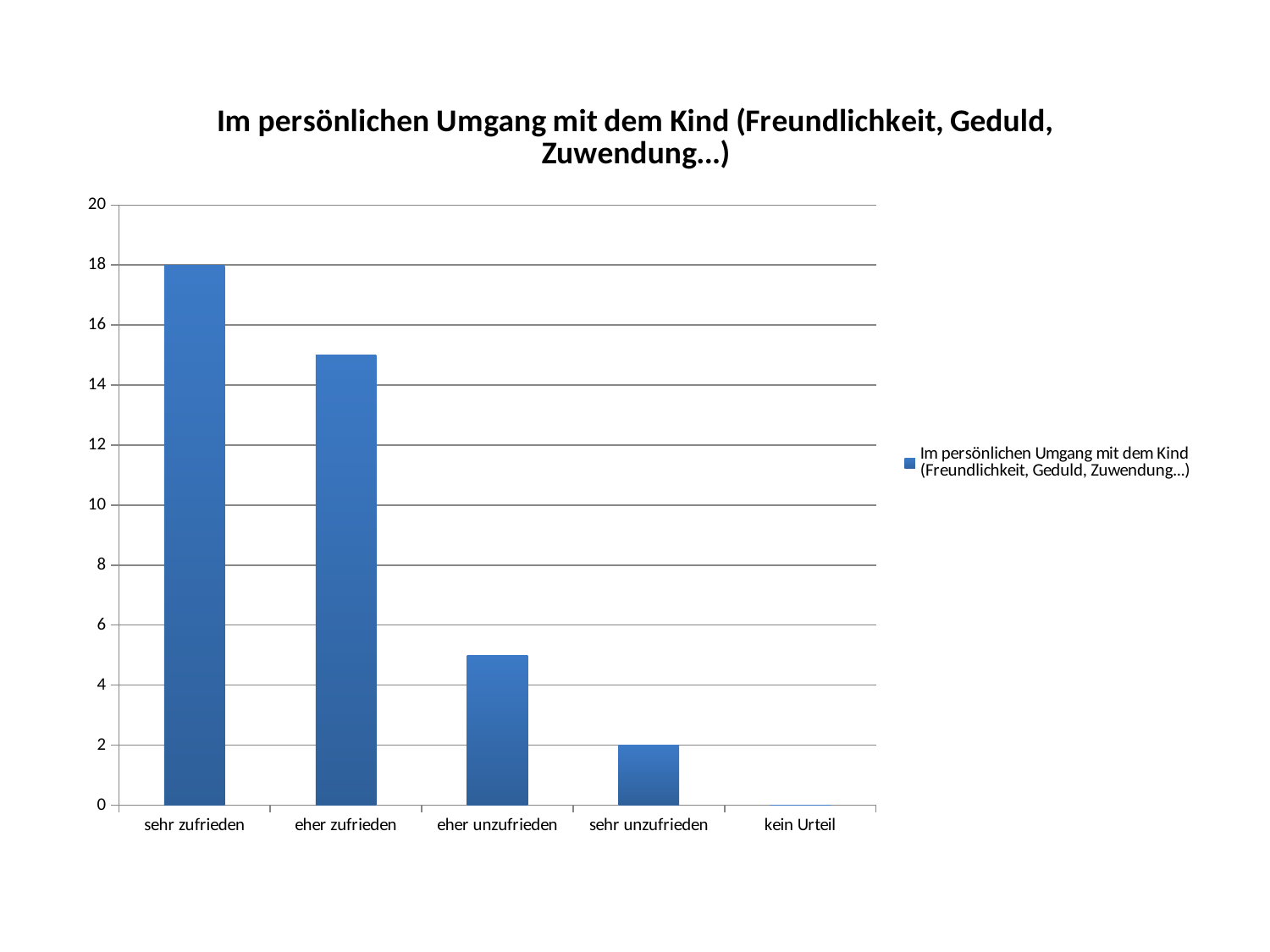
Which category has the lowest value? kein Urteil How many categories are shown on the x axis? 5 What is the value for "sehr unzufrieden"? 2 Which category has the highest value? sehr zufrieden What kind of chart is shown on the slide? bar chart Do the values rise or fall from left to right along the x axis? fall Is the value for "eher unzufrieden" greater or less than 6? less Which is larger, the value for "eher zufrieden" or the value for "eher unzufrieden"? eher zufrieden What is the value for "sehr zufrieden"? 18 What is the value for "kein Urteil"? 0 Is the value for "eher zufrieden" greater or less than 14? greater What is the difference between the values for "sehr zufrieden" and "sehr unzufrieden"? 16